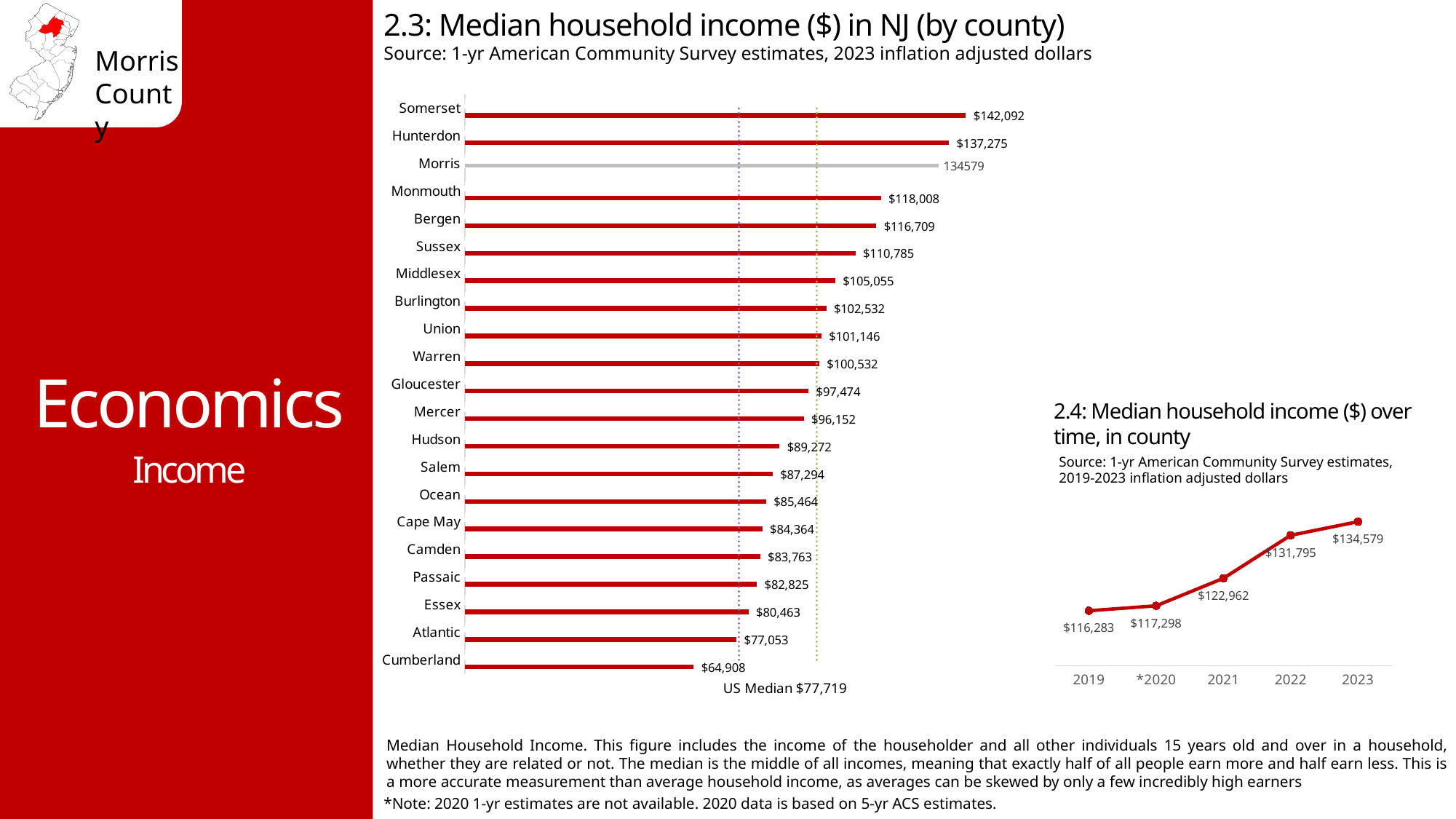
In chart 2.3 (Median household income in NJ by county), which county has a higher median household income, Bergen or Monmouth? Monmouth In chart 2.3 (Median household income in NJ by county), what value is labeled for Morris? 134579 In chart 2.3 (Median household income in NJ by county), what is the median household income for Somerset? $142,092 In chart 2.3 (Median household income in NJ by county), what US Median value is noted below the chart? $77,719 What kind of chart is chart 2.3 (Median household income in NJ by county)? Bar chart In chart 2.4 (Median household income over time, in county), what is the difference between the 2023 and 2019 values? $18,296 In chart 2.3 (Median household income in NJ by county), what is the difference between Somerset's and Hunterdon's median household income? $4,817 In chart 2.3 (Median household income in NJ by county), which county has the lowest median household income? Cumberland In chart 2.4 (Median household income over time, in county), do values rise or fall from 2019 to 2023? Rise In chart 2.4 (Median household income over time, in county), what is the value for 2021? $122,962 In chart 2.3 (Median household income in NJ by county), which county has the highest median household income? Somerset In chart 2.3 (Median household income in NJ by county), how many counties are shown? 21